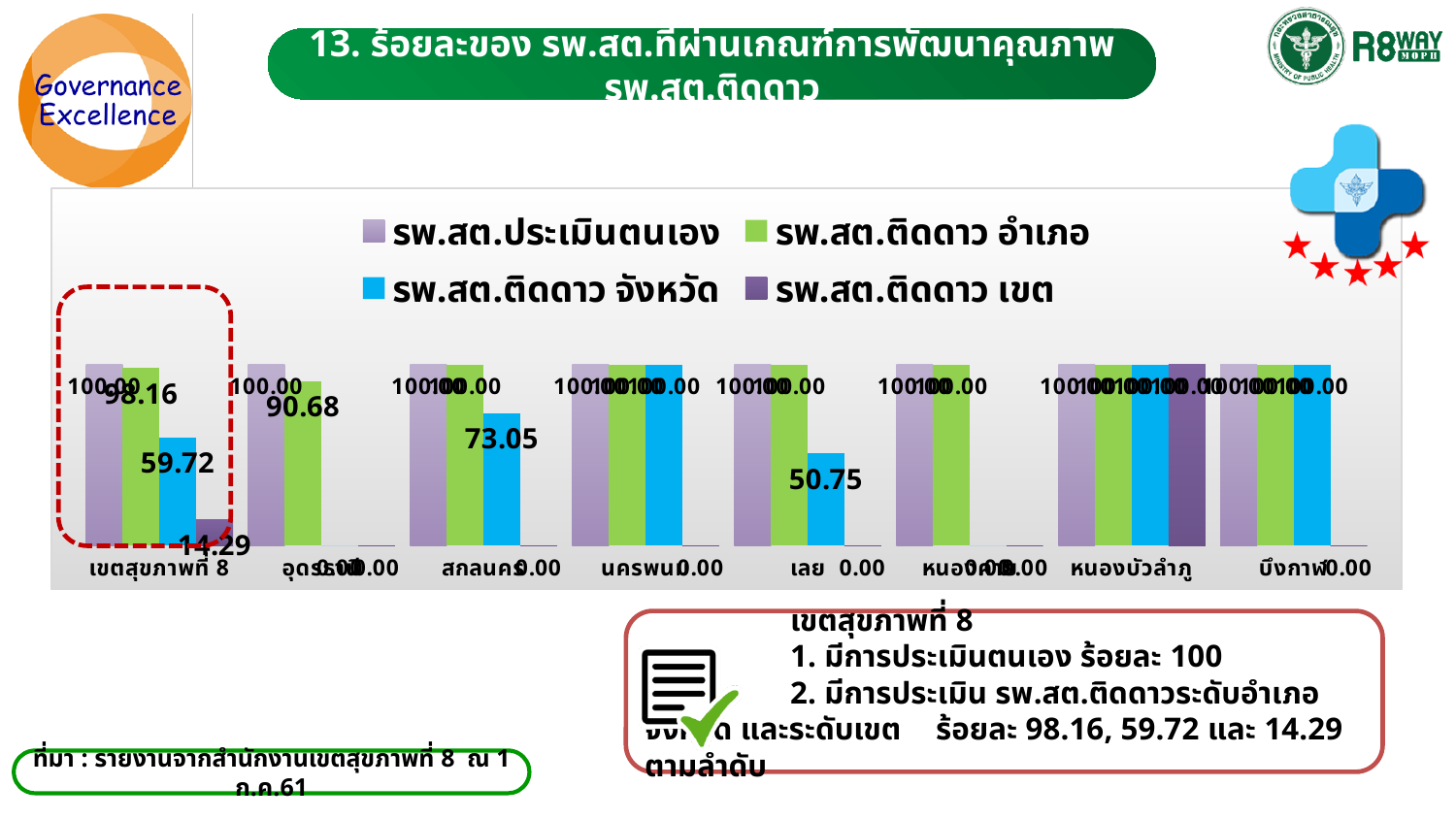
What is the value of รพ.สต.ติดดาว จังหวัด for เขตสุขภาพที่ 8? 59.72 Which colour represents รพ.สต.ติดดาว จังหวัด in the legend? blue What is the difference between the รพ.สต.ติดดาว จังหวัด values for สกลนคร and เลย? 22.30 What is the value of รพ.สต.ติดดาว จังหวัด for สกลนคร? 73.05 How many series does the legend list? 4 Which series has the lowest value for เขตสุขภาพที่ 8? รพ.สต.ติดดาว เขต What is the value of รพ.สต.ติดดาว เขต for เขตสุขภาพที่ 8? 14.29 What kind of chart is shown on the slide? bar chart What is the value of รพ.สต.ติดดาว อำเภอ for อุดรธานี? 90.68 What is the value of รพ.สต.ติดดาว อำเภอ for เขตสุขภาพที่ 8? 98.16 How many categories are shown along the x axis? 8 What is the value of รพ.สต.ติดดาว จังหวัด for เลย? 50.75